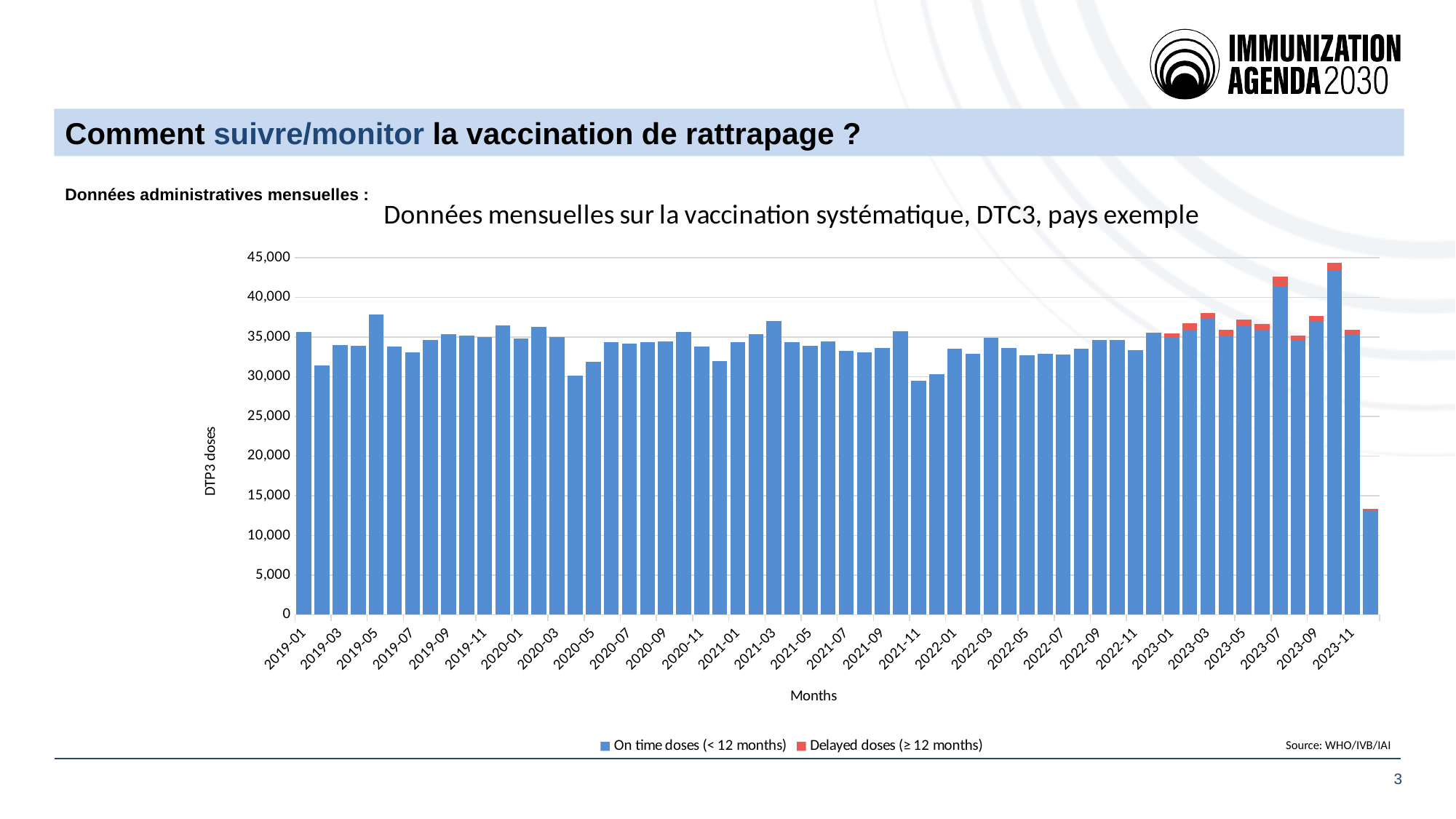
Is the value for 2023-07 greater or less than 40,000? greater What kind of chart is shown on the slide? Stacked bar chart Is the value for 2019-03 greater or less than 35,000? less Is the value for 2022-01 greater or less than 35,000? less What is the title of the chart? Données mensuelles sur la vaccination systématique, DTC3, pays exemple How many monthly bars are plotted on the chart? 60 What are the two series named in the chart legend? On time doses (< 12 months) and Delayed doses (≥ 12 months) How many series does the chart legend list? 2 Between 2022-11 and 2023-07, do the monthly totals generally rise or fall? rise Which month has the larger total, 2023-07 or 2019-03? 2023-07 Which month has the larger total, 2019-05 or 2019-07? 2019-05